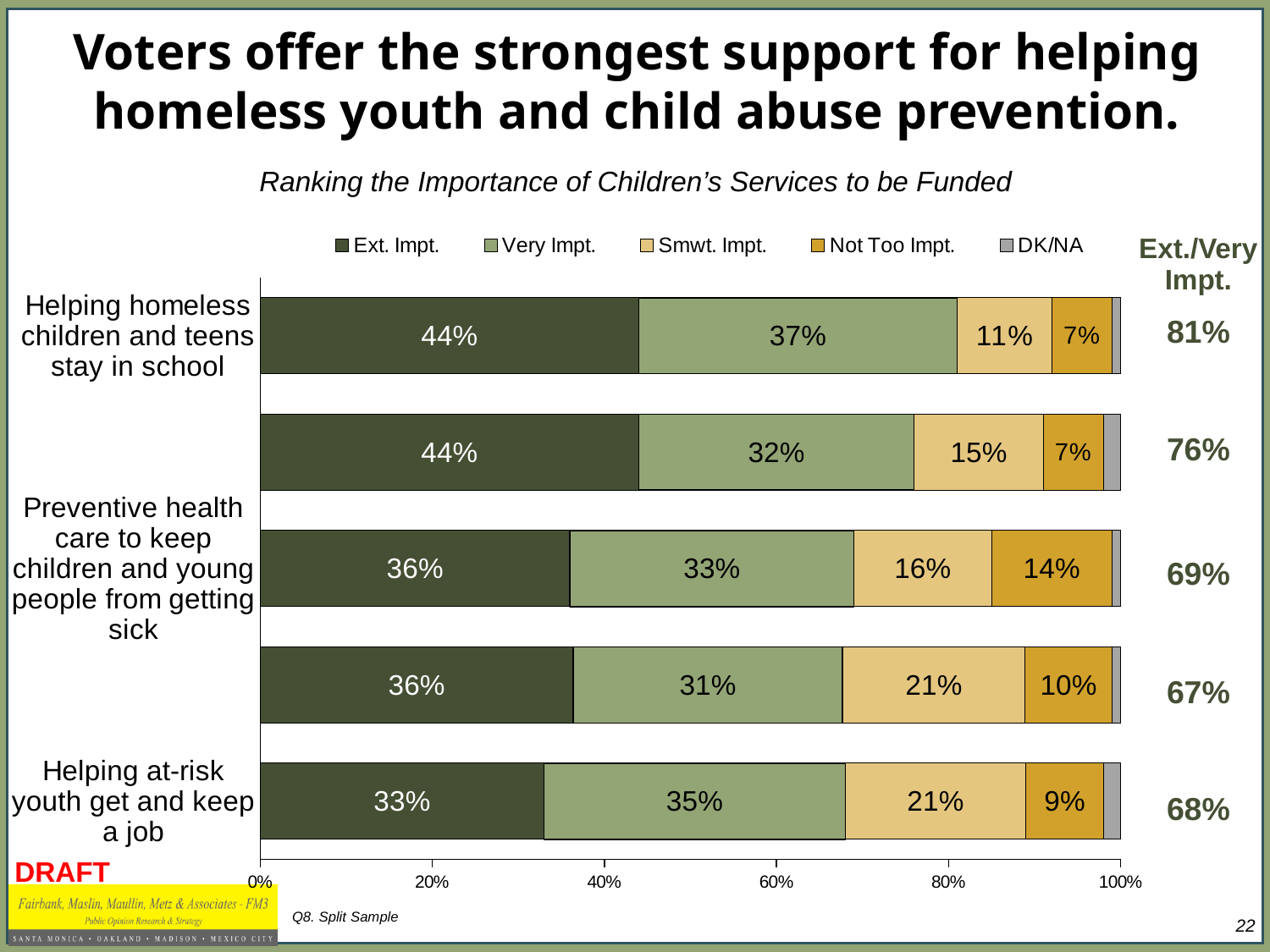
Which has the larger Smwt. Impt. value: 'Preventive health care to keep children and young people from getting sick' or 'Helping at-risk youth get and keep a job'? Helping at-risk youth get and keep a job What is the Not Too Impt. value for 'Preventive health care to keep children and young people from getting sick'? 14% What percentage of voters rated 'Helping homeless children and teens stay in school' as Ext. Impt.? 44% What is the combined Ext./Very Impt. figure shown for 'Helping homeless children and teens stay in school'? 81% What is the difference in the Ext. Impt. value between 'Helping homeless children and teens stay in school' and 'Helping at-risk youth get and keep a job'? 11 percentage points What kind of chart is shown on the slide? Stacked bar chart How many series does the legend list? 5 What is the difference between the Ext./Very Impt. figures for 'Helping homeless children and teens stay in school' and 'Preventive health care to keep children and young people from getting sick'? 12 percentage points What is the Very Impt. value for 'Helping at-risk youth get and keep a job'? 35% Which category has the highest combined Ext./Very Impt. figure? Helping homeless children and teens stay in school What is the first entry in the chart's legend? Ext. Impt. How many bars are plotted in the chart? 5